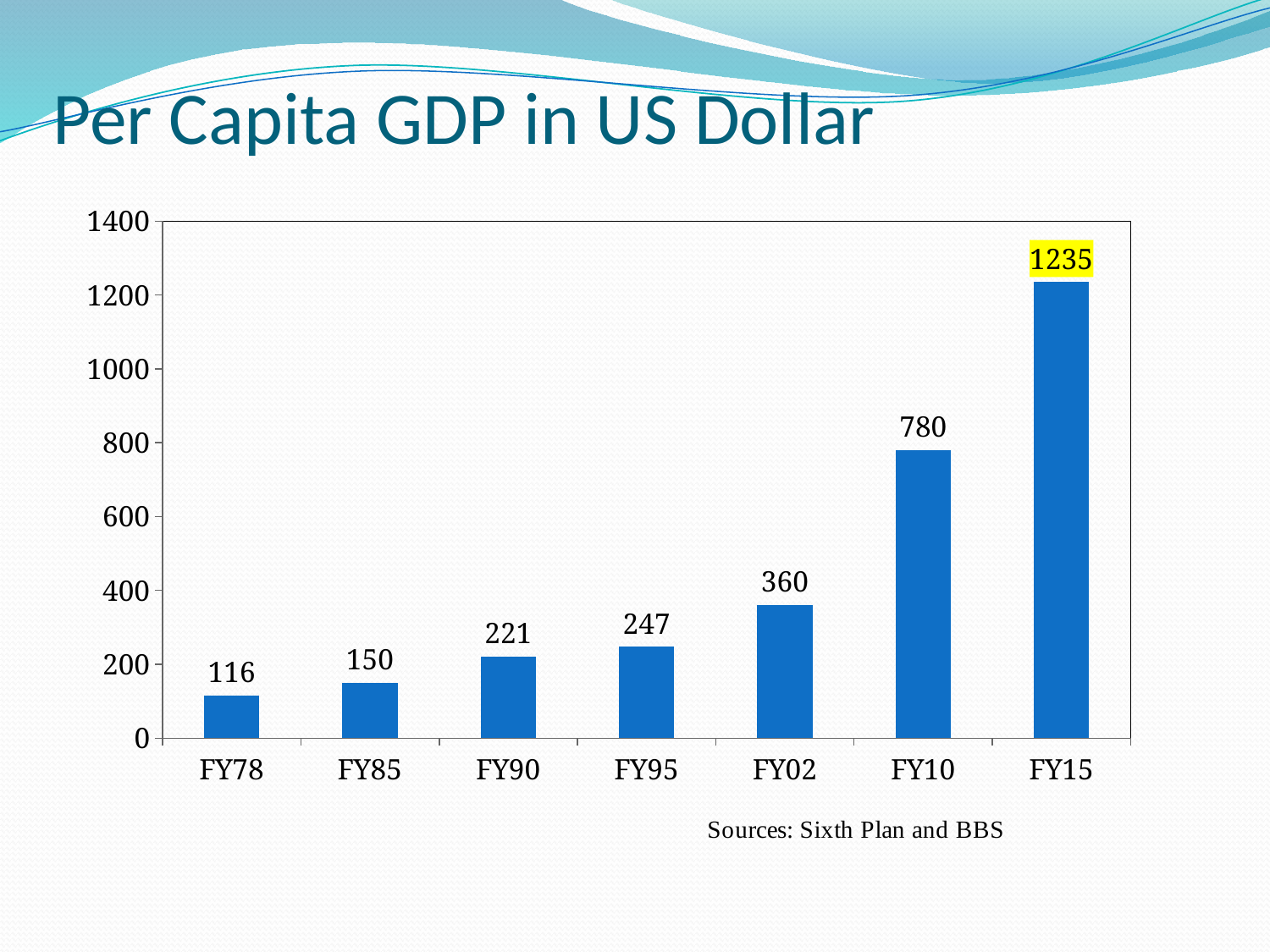
Which fiscal year has the lowest per capita GDP on the chart? FY78 What is the per capita GDP value shown for FY78? 116 What kind of chart is shown on the slide? bar chart What is the per capita GDP value shown for FY02? 360 What is the difference between the per capita GDP values for FY95 and FY90? 26 What is the per capita GDP value shown for FY10? 780 Is the value for FY10 greater or less than 600? greater Which fiscal year has the highest per capita GDP on the chart? FY15 What is the difference between the per capita GDP values for FY15 and FY10? 455 Do the per capita GDP values rise or fall from FY78 to FY15? rise Which is larger, the per capita GDP for FY85 or for FY95? FY95 How many fiscal years are shown on the x axis of the chart? 7